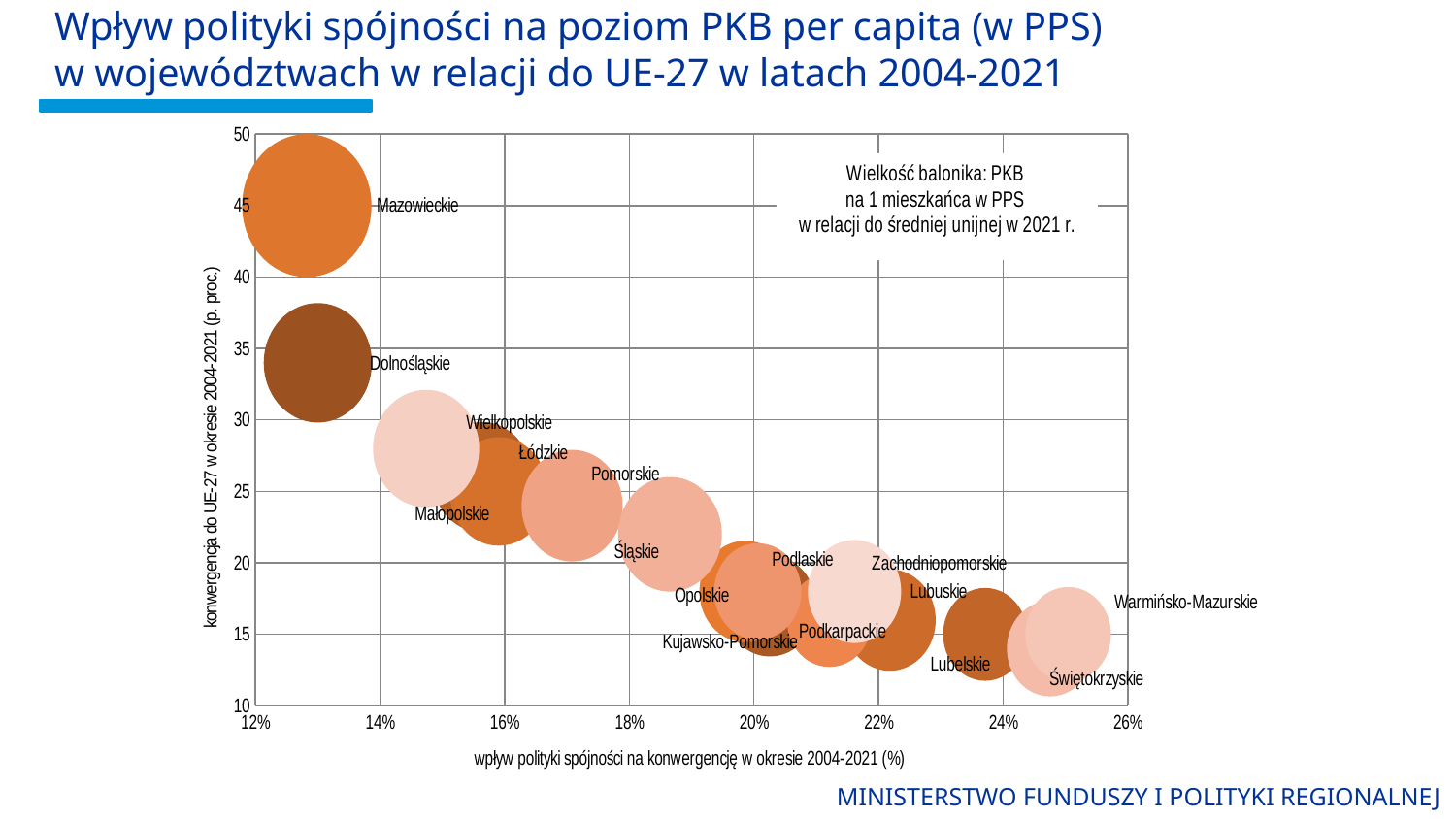
Is the horizontal-axis value for Mazowieckie greater or less than 14%? less Is the convergence value (vertical axis) for Mazowieckie greater or less than 40? greater According to the note on the chart, what does the bubble size represent? PKB na 1 mieszkańca w PPS w relacji do średniej unijnej w 2021 r. Is the convergence value (vertical axis) for Dolnośląskie greater or less than 30? greater As the horizontal-axis value increases, do the convergence values generally rise or fall? fall Which has a higher convergence value (vertical axis): Dolnośląskie or Pomorskie? Dolnośląskie Which voivodeship has the largest bubble on the chart? Mazowieckie Which voivodeship has the highest convergence to the EU-27 (vertical axis)? Mazowieckie How many voivodeships (bubbles) are plotted on the chart? 16 What kind of chart is shown on the slide? bubble chart